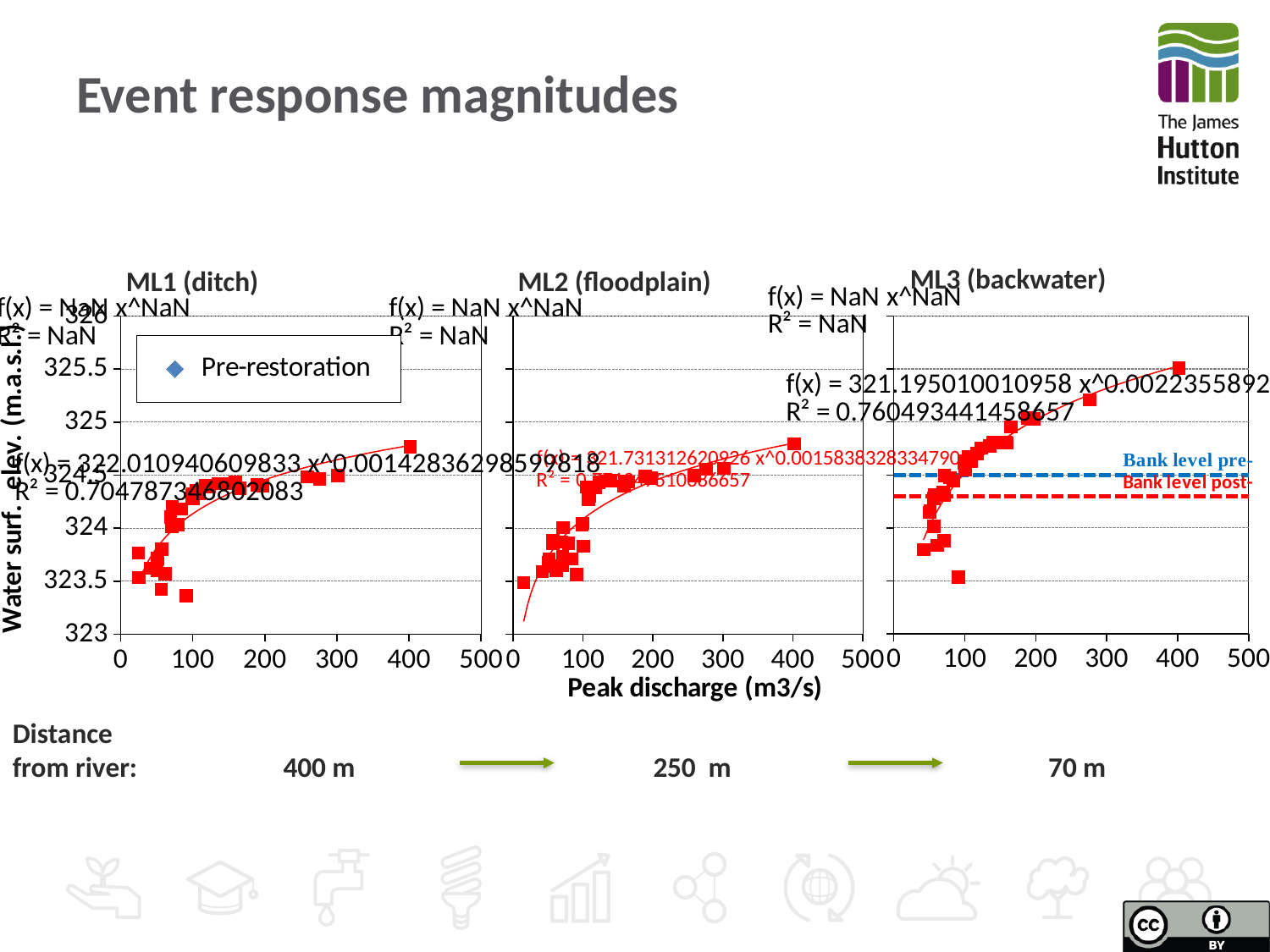
In the ML3 (backwater) chart, which dashed line is higher, Bank level pre- or Bank level post-? Bank level pre- How many charts are shown on the slide? 3 What kind of chart is used for ML1 (ditch), ML2 (floodplain) and ML3 (backwater)? Scatter chart Which chart has the larger printed R² value for its fitted trend line, ML1 (ditch) or ML3 (backwater)? ML3 (backwater) In the ML1 (ditch) chart, is the water surface elevation for the point at about 400 m3/s greater or less than 324.5? greater What R² value is printed for the fitted trend line in the ML1 (ditch) chart? 0.704787346802083 In the ML3 (backwater) chart, do the water surface elevation values rise or fall as peak discharge increases? Rise What R² value is printed for the fitted trend line in the ML3 (backwater) chart? 0.760493441458657 In the ML2 (floodplain) chart, is the water surface elevation for the lowest point greater or less than 324? less In the ML1 (ditch) chart, do the water surface elevation values rise or fall as peak discharge increases? Rise What series name is shown in the legend of the ML1 (ditch) chart? Pre-restoration In the ML3 (backwater) chart, is the water surface elevation for the highest point (at about 400 m3/s) greater or less than 325? greater